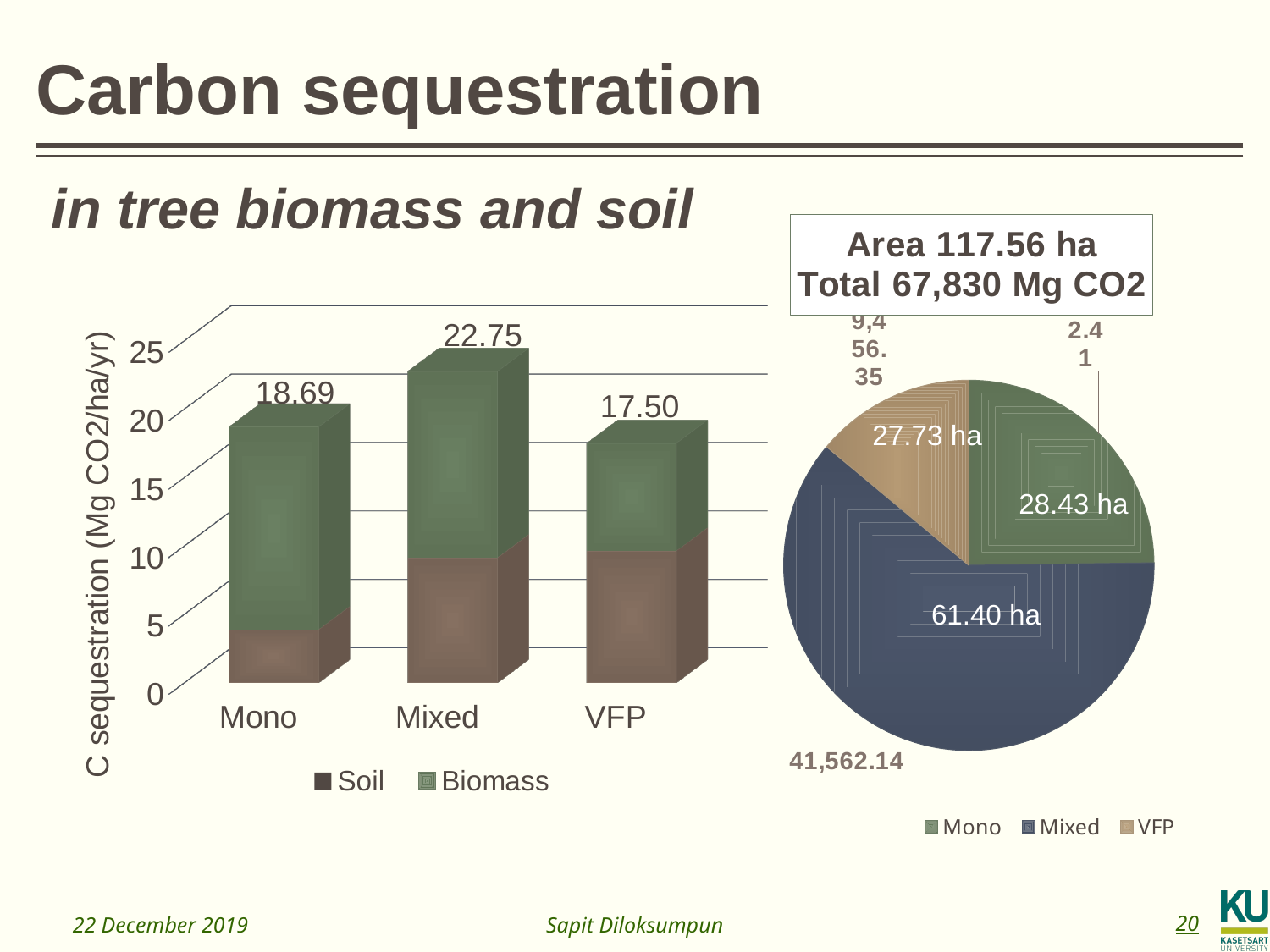
What kind of chart is the chart on the left of the slide? Stacked bar chart In the pie chart on the right, what is the difference in area between Mixed and Mono? 32.97 ha In the pie chart on the right, which category has the largest slice? Mixed In the bar chart on the left, what is the difference between the total C sequestration of Mixed and Mono? 4.06 In the bar chart on the left, what is the total C sequestration for Mixed? 22.75 In the bar chart on the left, which category has the highest total C sequestration? Mixed In the bar chart on the left, what is the total C sequestration for VFP? 17.50 In the bar chart on the left, how many series does the legend list? 2 In the bar chart on the left, which category has the lowest total C sequestration? VFP In the bar chart on the left, what is the total C sequestration for Mono? 18.69 In the pie chart on the right, what is the area for Mixed? 61.40 ha In the bar chart on the left, is the Soil value for Mixed greater or less than 10? less